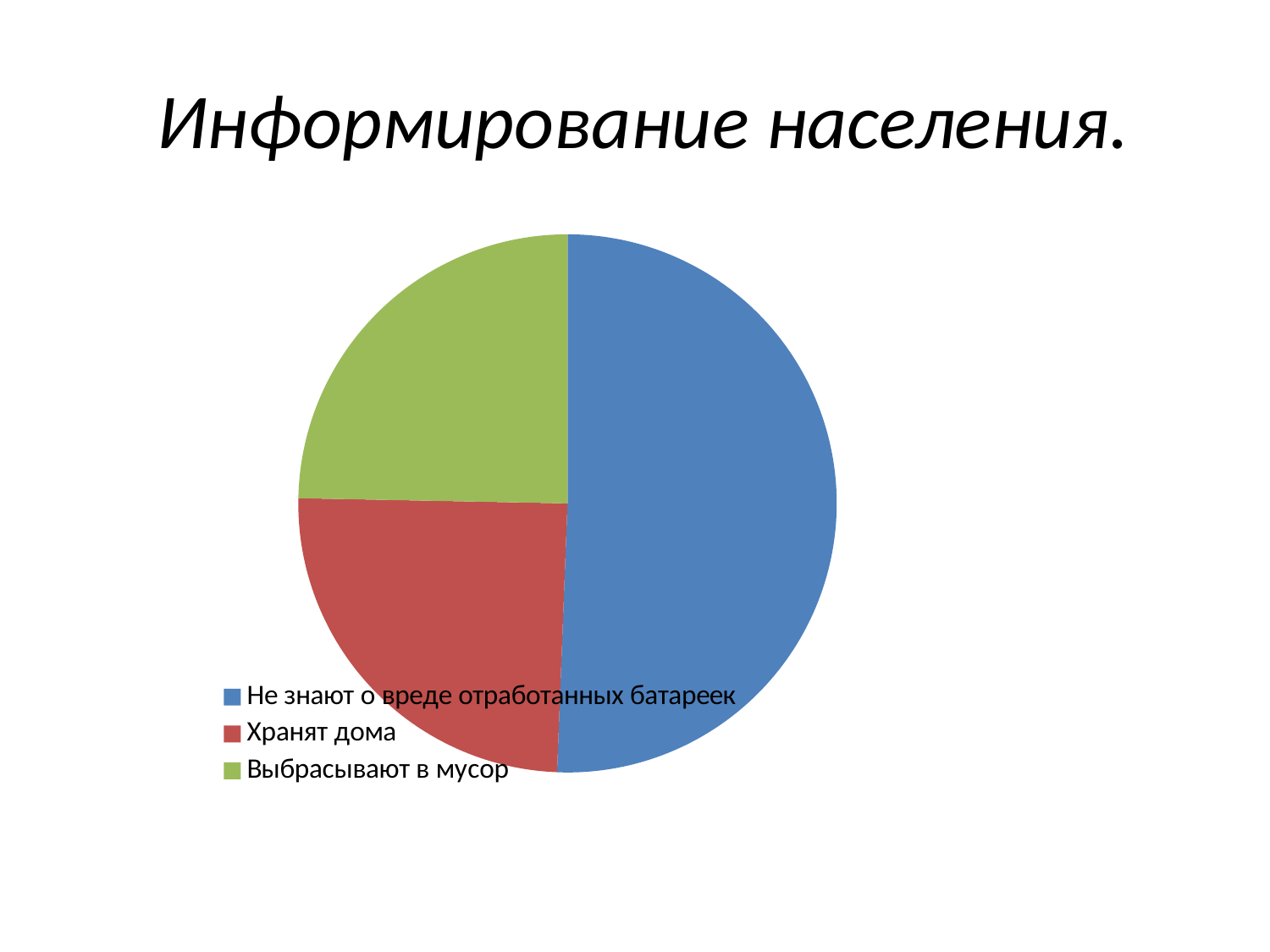
Which slice is larger: "Выбрасывают в мусор" or "Не знают о вреде отработанных батареек"? Не знают о вреде отработанных батареек Which category has the largest slice of the pie chart? Не знают о вреде отработанных батареек What kind of chart is shown on the slide? pie chart Which slice is larger: "Не знают о вреде отработанных батареек" or "Хранят дома"? Не знают о вреде отработанных батареек What colour is the slice for "Хранят дома" in the pie chart? red How many slices does the pie chart have? 3 How many entries does the legend of the pie chart list? 3 What is the title of the slide containing the pie chart? Информирование населения.